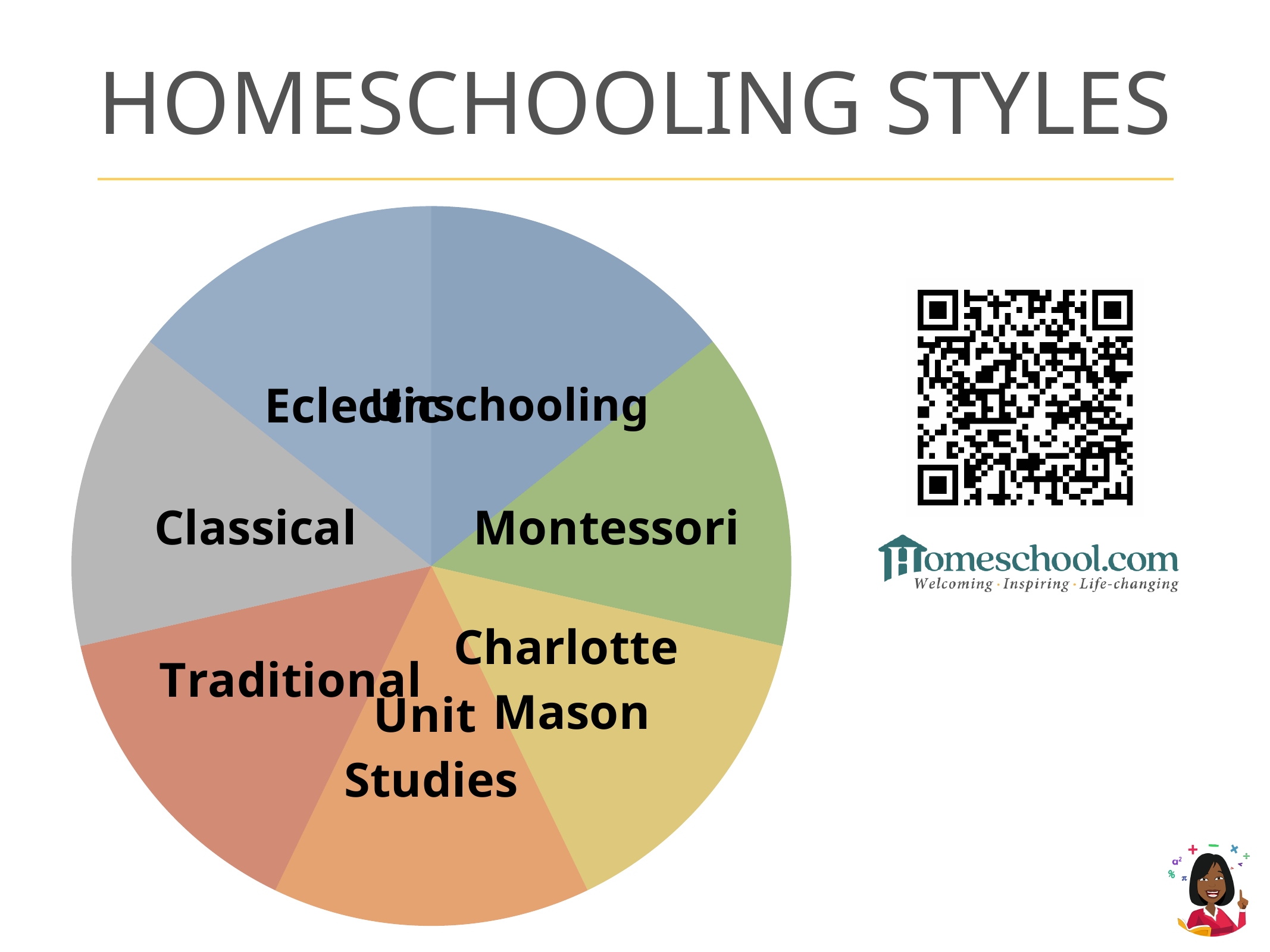
Which slice of the pie chart is coloured green? Montessori Which homeschooling style is labelled on the grey slice of the pie chart? Classical What is the title of the slide containing the pie chart? HOMESCHOOLING STYLES Which homeschooling style is labelled on the red slice of the pie chart? Traditional What kind of chart is shown on the slide? pie chart Which homeschooling style is labelled on the orange slice of the pie chart? Unit Studies Does the pie chart print any numeric values or percentages on its slices? No How many slices does the pie chart have? 7 Which homeschooling style is labelled on the yellow slice of the pie chart? Charlotte Mason